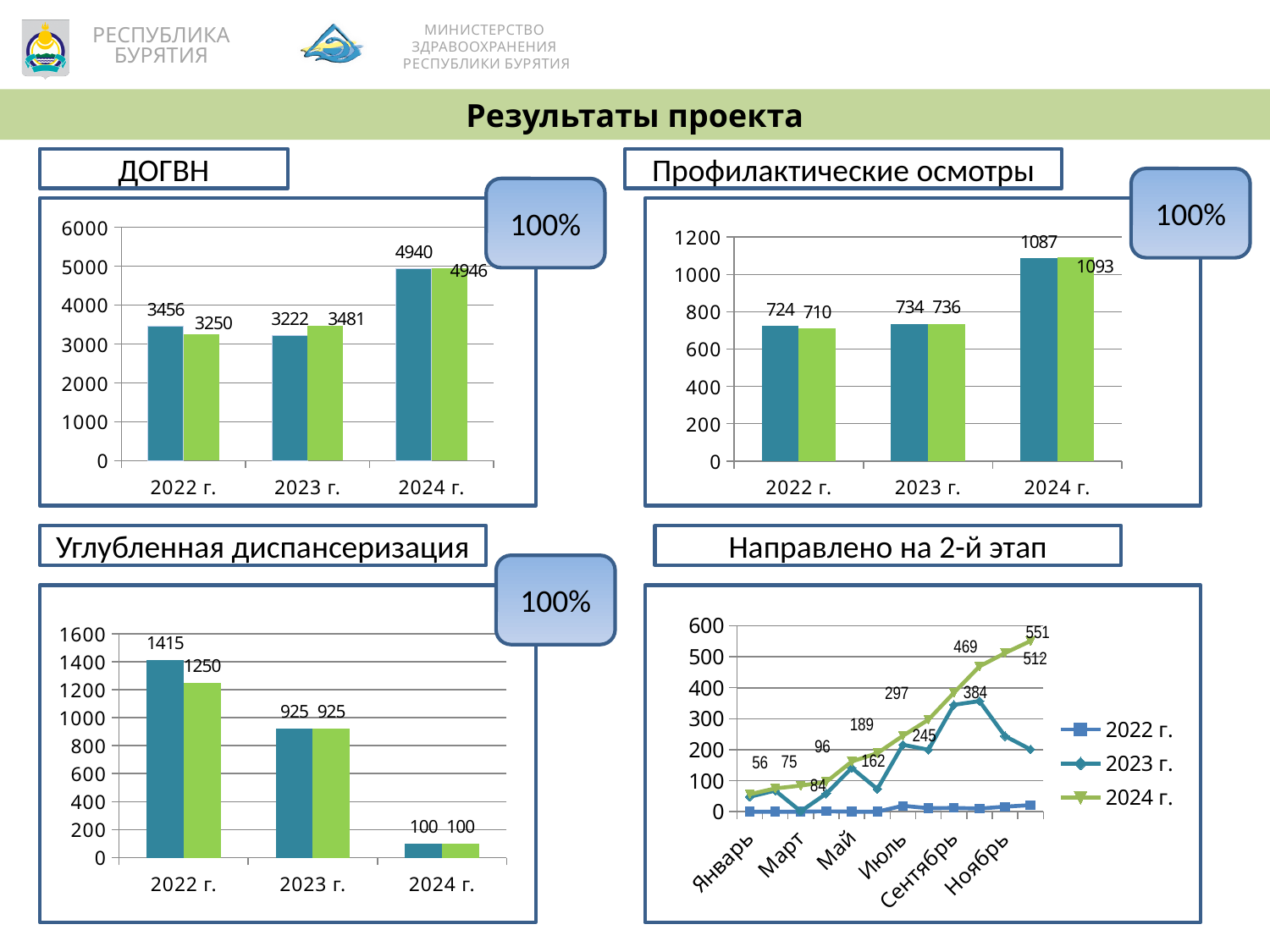
In the ДОГВН chart, what is the value of the first (teal) bar for 2024 г.? 4940 In the Профилактические осмотры chart, what is the value of the green bar for 2024 г.? 1093 In the ДОГВН chart, what is the value of the second (green) bar for 2023 г.? 3481 In the Углубленная диспансеризация chart, do the values rise or fall from 2022 г. to 2024 г.? fall In the Углубленная диспансеризация chart, what is the value of the teal bar for 2022 г.? 1415 In the Углубленная диспансеризация chart, which year has the lowest values? 2024 г. In the Профилактические осмотры chart, is the teal bar for 2023 г. greater or less than 800? less What kind of chart is the Направлено на 2-й этап chart? line chart In the Направлено на 2-й этап chart, which series stays lowest across all months? 2022 г. In the Профилактические осмотры chart, which year has the highest values? 2024 г. How many series does the legend of the Направлено на 2-й этап chart list? 3 In the ДОГВН chart, what is the difference between the two bars for 2022 г.? 206